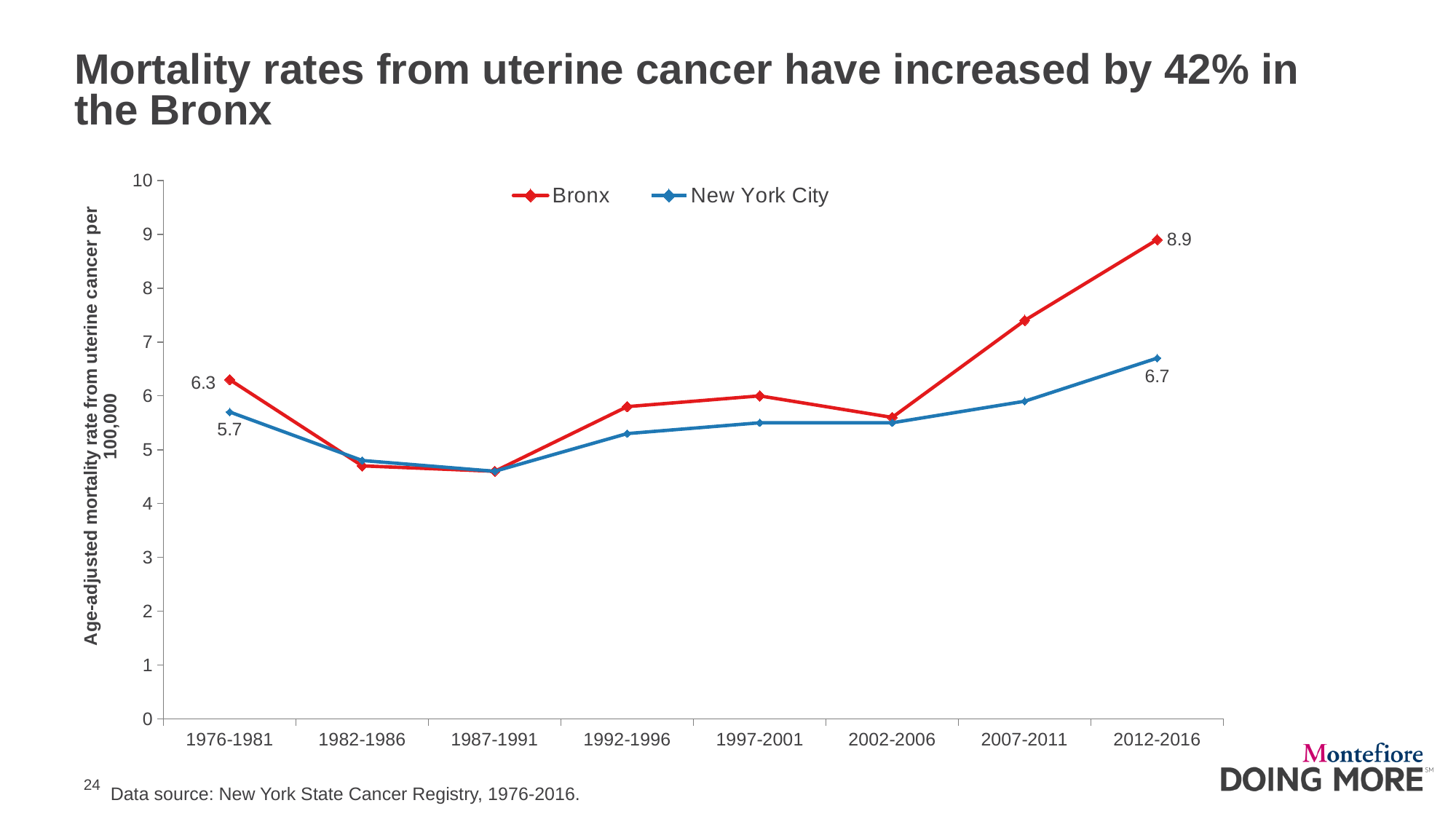
How many series does the legend list? 2 What is the Bronx mortality rate for 2012-2016? 8.9 What is the New York City mortality rate for 2012-2016? 6.7 By how much did the Bronx mortality rate change from 1976-1981 to 2012-2016? 2.6 Which series has the higher value in 2007-2011, Bronx or New York City? Bronx Is the Bronx value for 2007-2011 greater or less than 7? greater What is the Bronx mortality rate for 1976-1981? 6.3 What is the New York City mortality rate for 1976-1981? 5.7 How many time periods are shown on the x axis? 8 What is the difference between the Bronx and New York City mortality rates in 2012-2016? 2.2 What kind of chart is shown on the slide? Line chart In which period is the Bronx mortality rate highest? 2012-2016